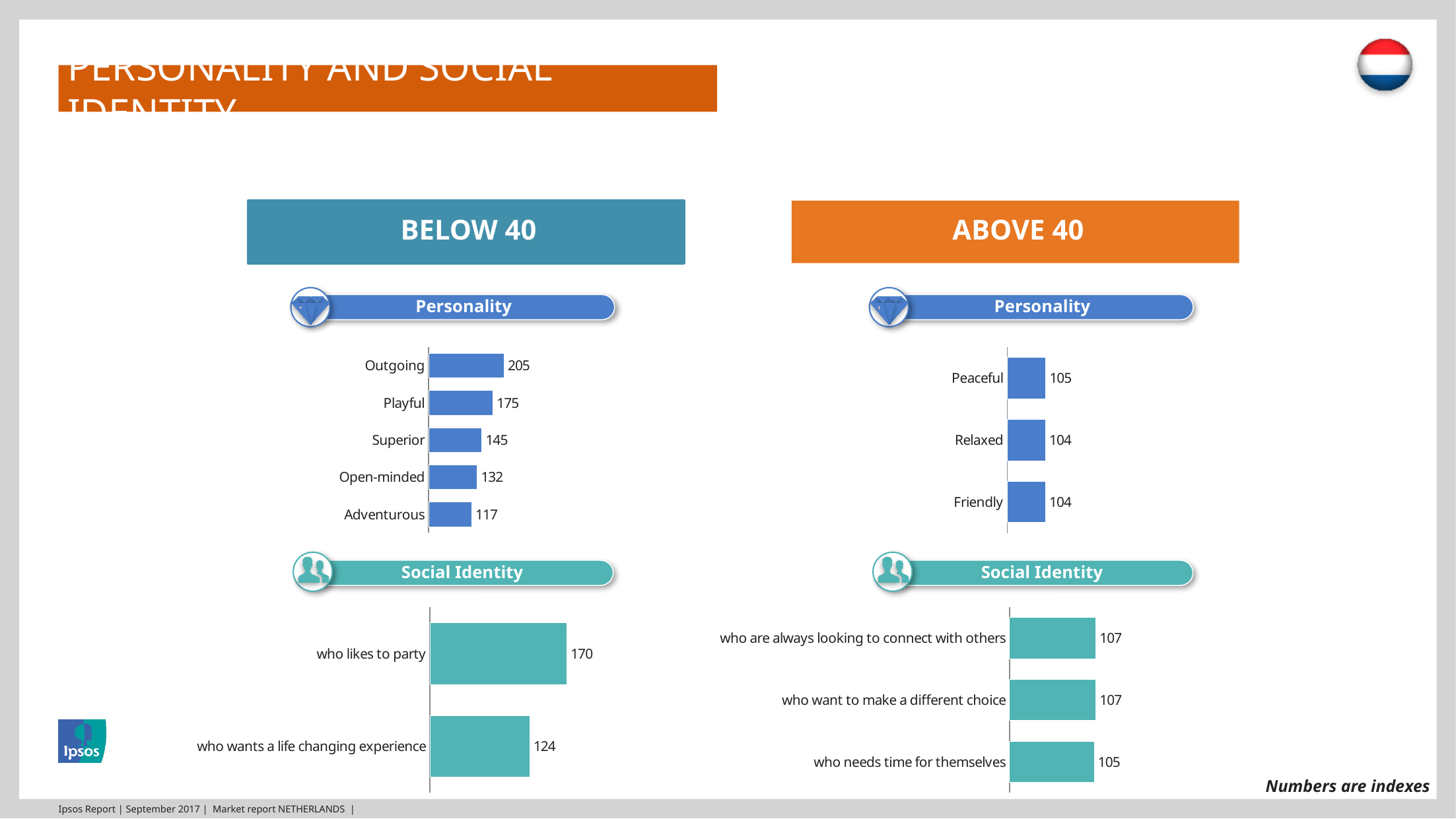
In the Below 40 Personality chart, what is the difference between Playful and Superior? 30 In the Below 40 Personality chart, what is the value for Outgoing? 205 In the Above 40 Social Identity chart, what is the value for 'who needs time for themselves'? 105 In the Above 40 Personality chart, what is the value for Peaceful? 105 In the Below 40 Social Identity chart, what is the value for 'who likes to party'? 170 In the Above 40 Personality chart, which category has the highest value? Peaceful Which is larger: Open-minded in the Below 40 Personality chart or 'who wants a life changing experience' in the Below 40 Social Identity chart? Open-minded What type of chart is the Below 40 Personality chart? Bar chart How many categories are shown in the Above 40 Social Identity chart? 3 How many categories are shown in the Below 40 Personality chart? 5 In the Below 40 Social Identity chart, what is the difference between 'who likes to party' and 'who wants a life changing experience'? 46 In the Below 40 Personality chart, which category has the lowest value? Adventurous